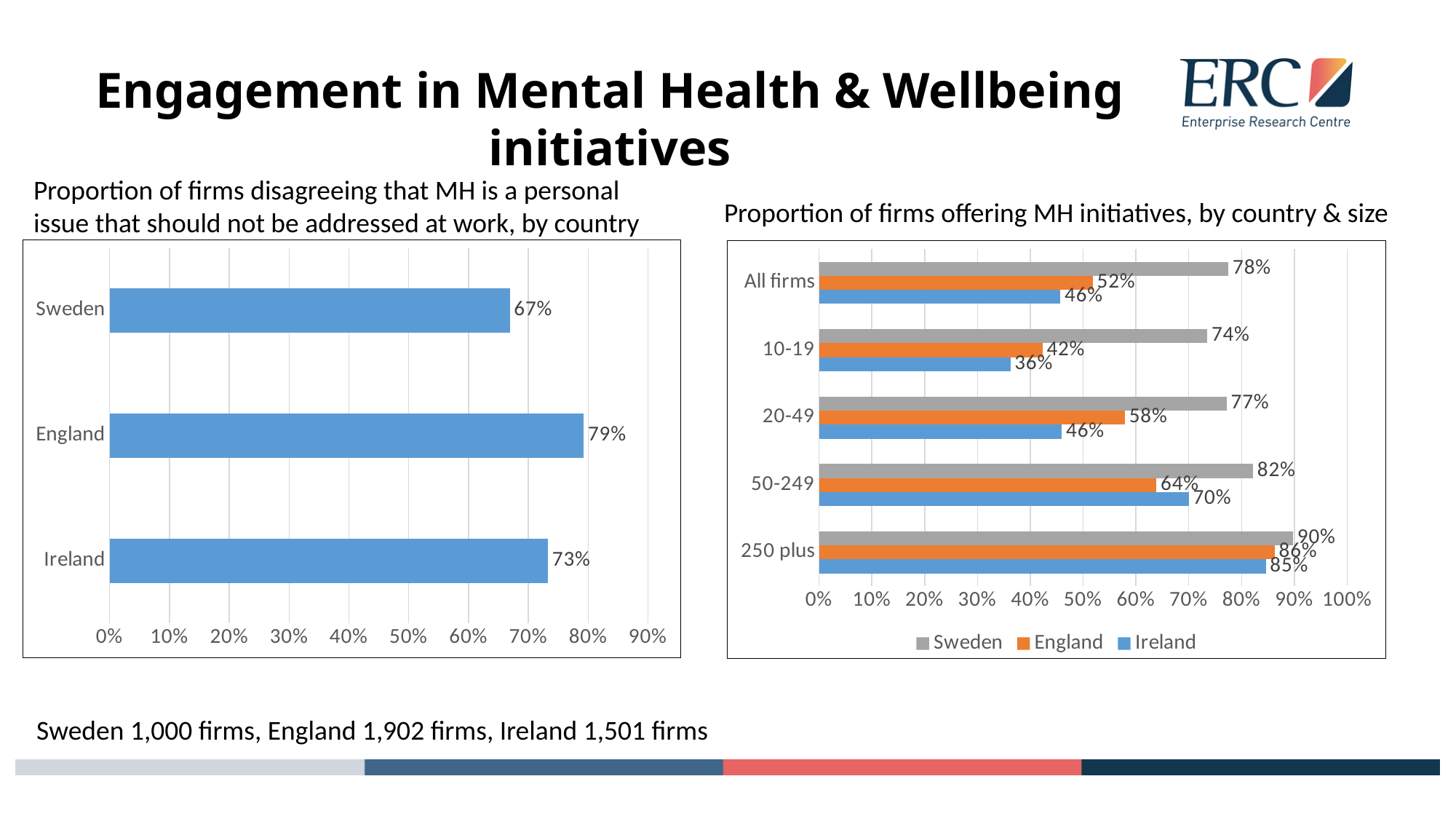
In the left chart (proportion of firms disagreeing that MH is a personal issue), how many countries are shown? 3 In the right chart (proportion of firms offering MH initiatives), which size category has the lowest value for Ireland? 10-19 In the right chart (proportion of firms offering MH initiatives), which size category has the highest value for England? 250 plus In the left chart (proportion of firms disagreeing that MH is a personal issue), which country has the lowest value? Sweden In the right chart (proportion of firms offering MH initiatives), what is the difference between Sweden and Ireland for firms with 10-19 employees? 38% How many series does the legend of the right chart (proportion of firms offering MH initiatives) list? 3 In the right chart (proportion of firms offering MH initiatives), what is the value for Sweden for All firms? 78% In the left chart (proportion of firms disagreeing that MH is a personal issue), what is the value for England? 79% What kind of chart is the left chart (proportion of firms disagreeing that MH is a personal issue)? Bar chart In the right chart (proportion of firms offering MH initiatives), what is the value for Ireland among firms with 50-249 employees? 70% In the right chart (proportion of firms offering MH initiatives), which is larger for firms with 20-49 employees: England or Ireland? England In the left chart (proportion of firms disagreeing that MH is a personal issue), what is the difference between England and Ireland? 6%